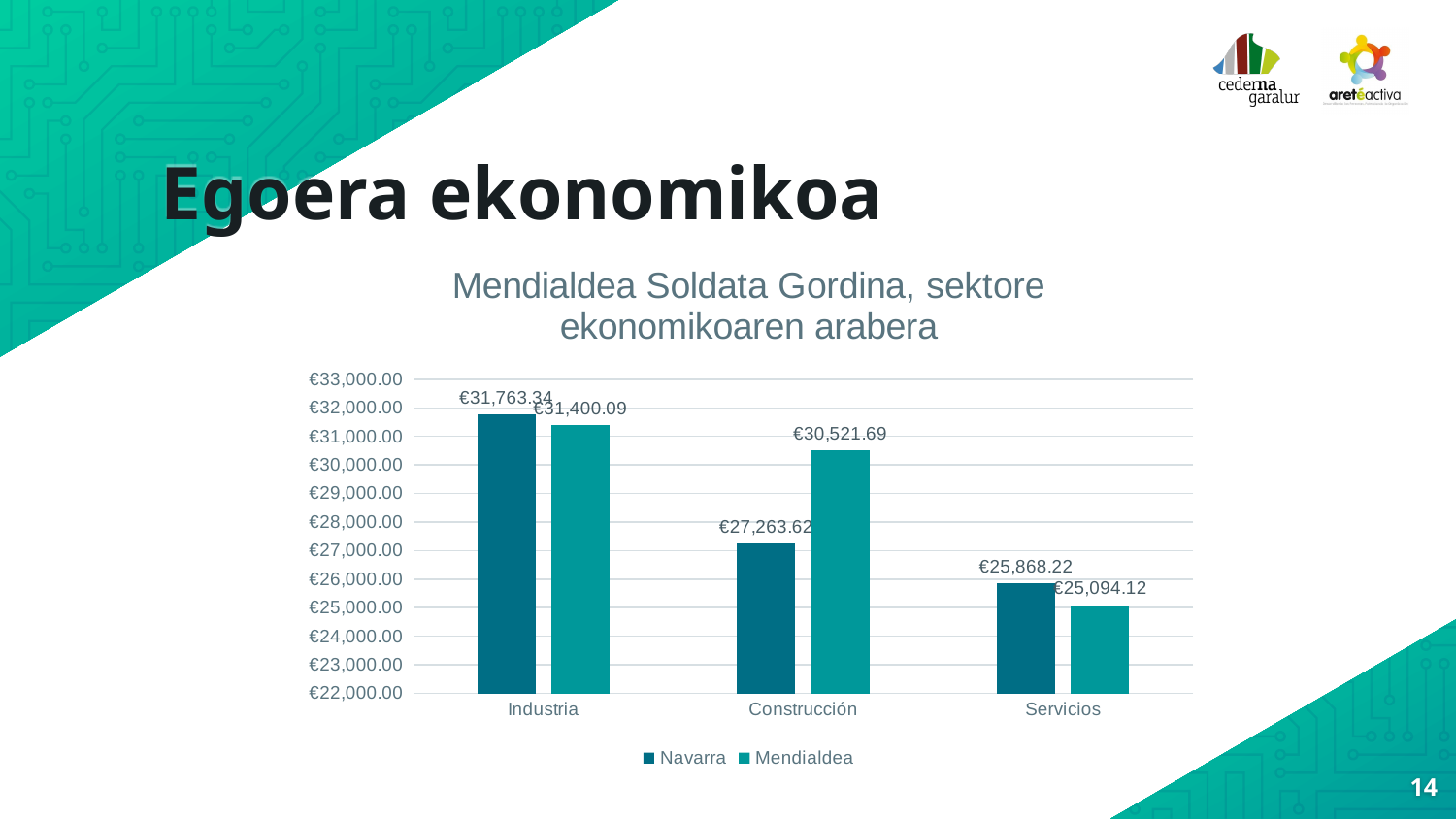
Which sector has the lowest Mendialdea value? Servicios For Construcción, which is larger: Navarra or Mendialdea? Mendialdea What is the Navarra value for Industria? €31,763.34 Do the Navarra values rise or fall from Industria to Servicios? fall Which sector has the highest Navarra value? Industria How many series does the legend list? 2 What is the Mendialdea value for Construcción? €30,521.69 What is the difference between the Navarra and Mendialdea values for Servicios? €774.10 Is the Navarra value for Construcción greater or less than €28,000.00? less What is the Mendialdea value for Servicios? €25,094.12 What is the difference between the Mendialdea and Navarra values for Construcción? €3,258.07 How many sectors are shown on the x axis? 3